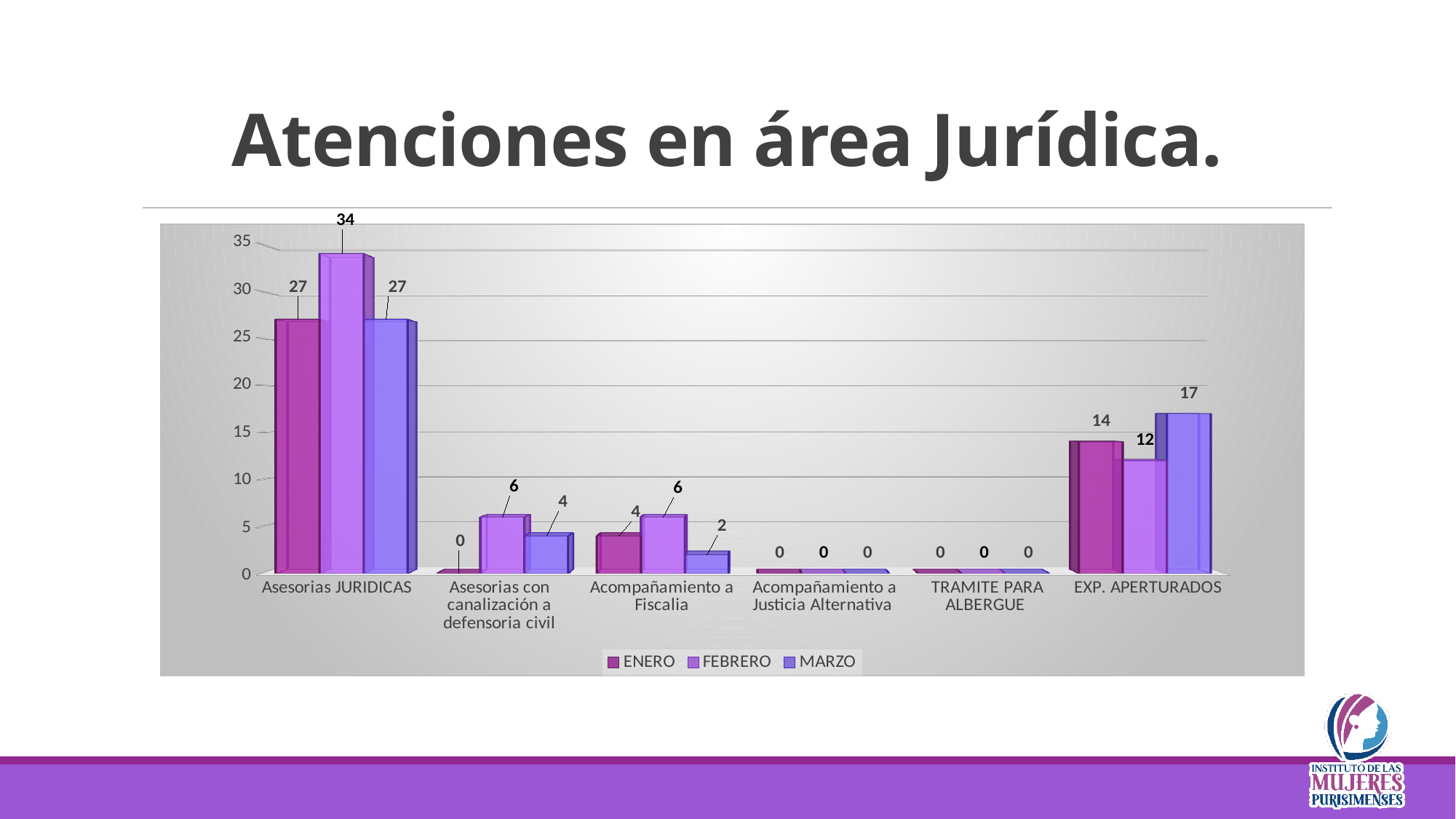
What is the ENERO value for Asesorias con canalización a defensoria civil? 0 How many series does the legend list? 3 What is the title of the slide? Atenciones en área Jurídica. Which series is shown in the darkest purple colour in the legend? ENERO What is the difference between the FEBRERO and ENERO values for Asesorias JURIDICAS? 7 What kind of chart is shown on the slide? Bar chart Which category has the highest FEBRERO value? Asesorias JURIDICAS How many categories are shown on the x axis? 6 What is the MARZO value for Acompañamiento a Fiscalia? 2 Which is larger for EXP. APERTURADOS, the ENERO value or the FEBRERO value? ENERO What is the FEBRERO value for Asesorias JURIDICAS? 34 What is the MARZO value for EXP. APERTURADOS? 17